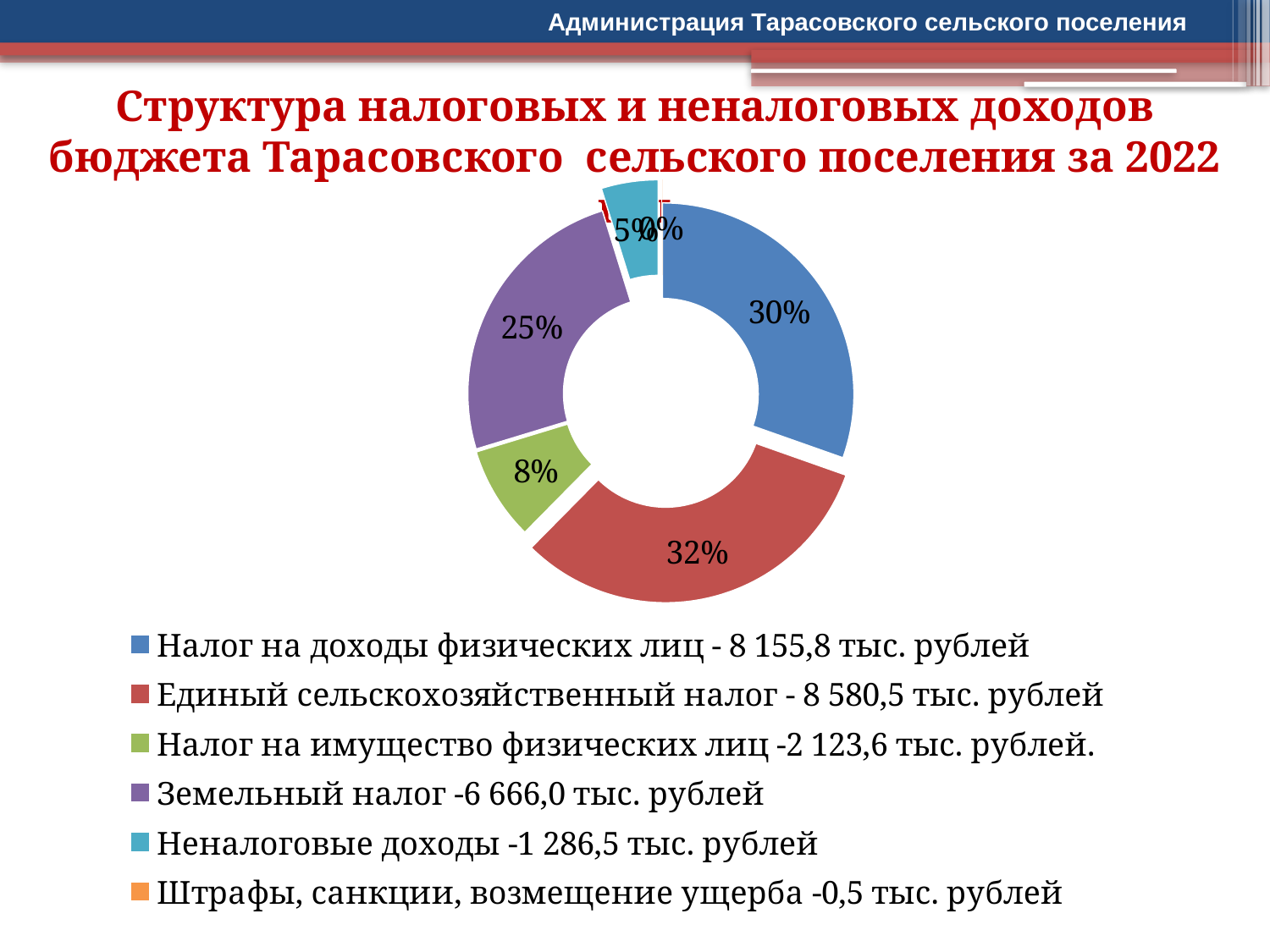
What percentage is shown for Земельный налог? 25% Which is larger: the share for Земельный налог or the share for Налог на имущество физических лиц? Земельный налог According to the legend, what amount in тыс. рублей is given for Земельный налог? 6 666,0 тыс. рублей What percentage is shown for Налог на доходы физических лиц? 30% What is the difference in percentage points between Единый сельскохозяйственный налог and Налог на доходы физических лиц? 2 percentage points What type of chart is shown on the slide? Doughnut (pie) chart Which category has the largest share of the chart? Единый сельскохозяйственный налог What percentage is shown for Неналоговые доходы? 5% Which category has the smallest share of the chart? Штрафы, санкции, возмещение ущерба How many categories does the legend list? 6 What share of the doughnut chart does Единый сельскохозяйственный налог represent? 32% What percentage is shown for Налог на имущество физических лиц? 8%